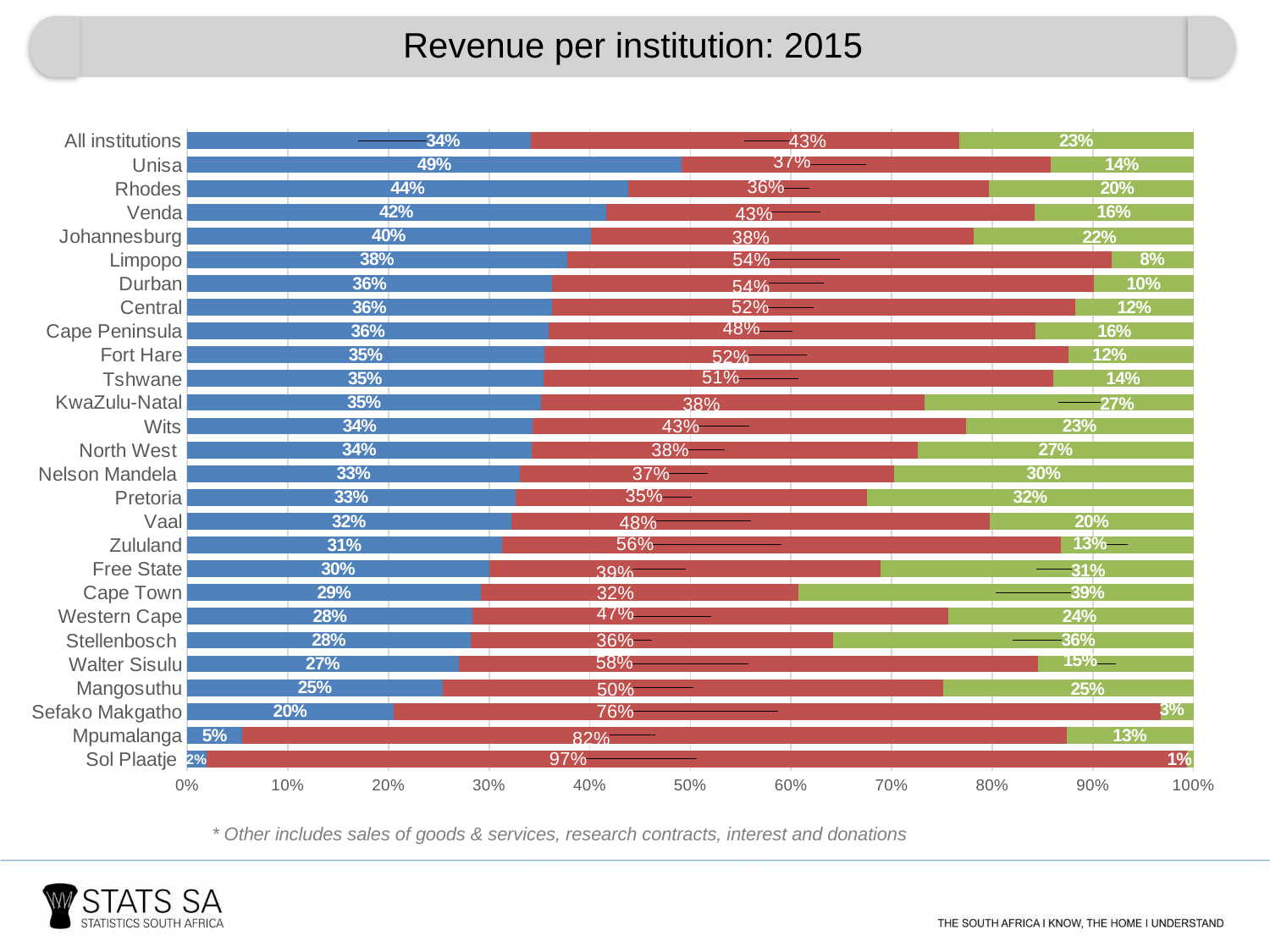
How many institution categories (including All institutions) are shown on the chart? 27 What type of chart is shown on the slide? Stacked bar chart Which has the larger red segment, Limpopo or Johannesburg? Limpopo What is the value of the red segment for Sol Plaatje? 97% Which institution has the largest green segment? Cape Town Which institution has the largest red segment? Sol Plaatje For All institutions, how much larger is the red segment than the blue segment? 9 percentage points What is the value of the blue segment for Unisa? 49% Which institution has the largest blue segment? Unisa What is the value of the green segment for Cape Town? 39% What is the value of the blue segment for Mpumalanga? 5% Which institution has the smallest blue segment? Sol Plaatje